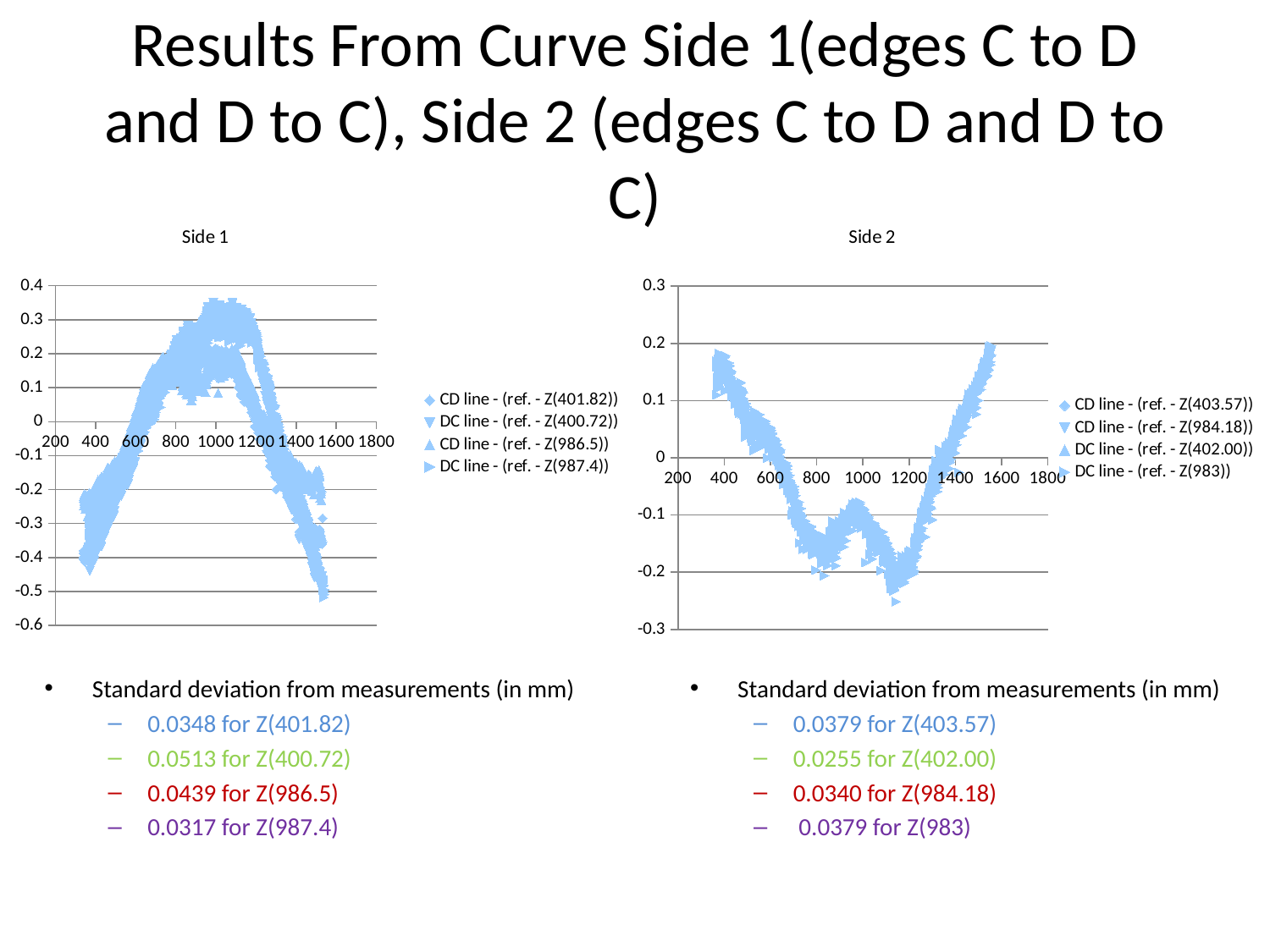
In the Side 1 chart, is the lowest plotted value (around x = 1500) greater or less than -0.4? less What is the maximum value shown on the vertical axis of the Side 2 chart? 0.3 What is the title of the chart on the left of the slide? Side 1 In the Side 2 chart, is the lowest plotted value (around x = 1150) greater or less than -0.2? less How many series does the legend of the Side 2 chart list? 4 In the Side 2 chart, are the plotted values near x = 400 greater or less than 0.1? greater In the Side 1 chart, do the plotted values rise or fall as x goes from 1100 to 1500? fall In the Side 2 chart, what is the first legend entry? CD line - (ref. - Z(403.57)) What kind of chart is the Side 1 chart? scatter chart How many series does the legend of the Side 1 chart list? 4 In the Side 2 chart, do the plotted values rise or fall as x goes from 1200 to 1550? rise